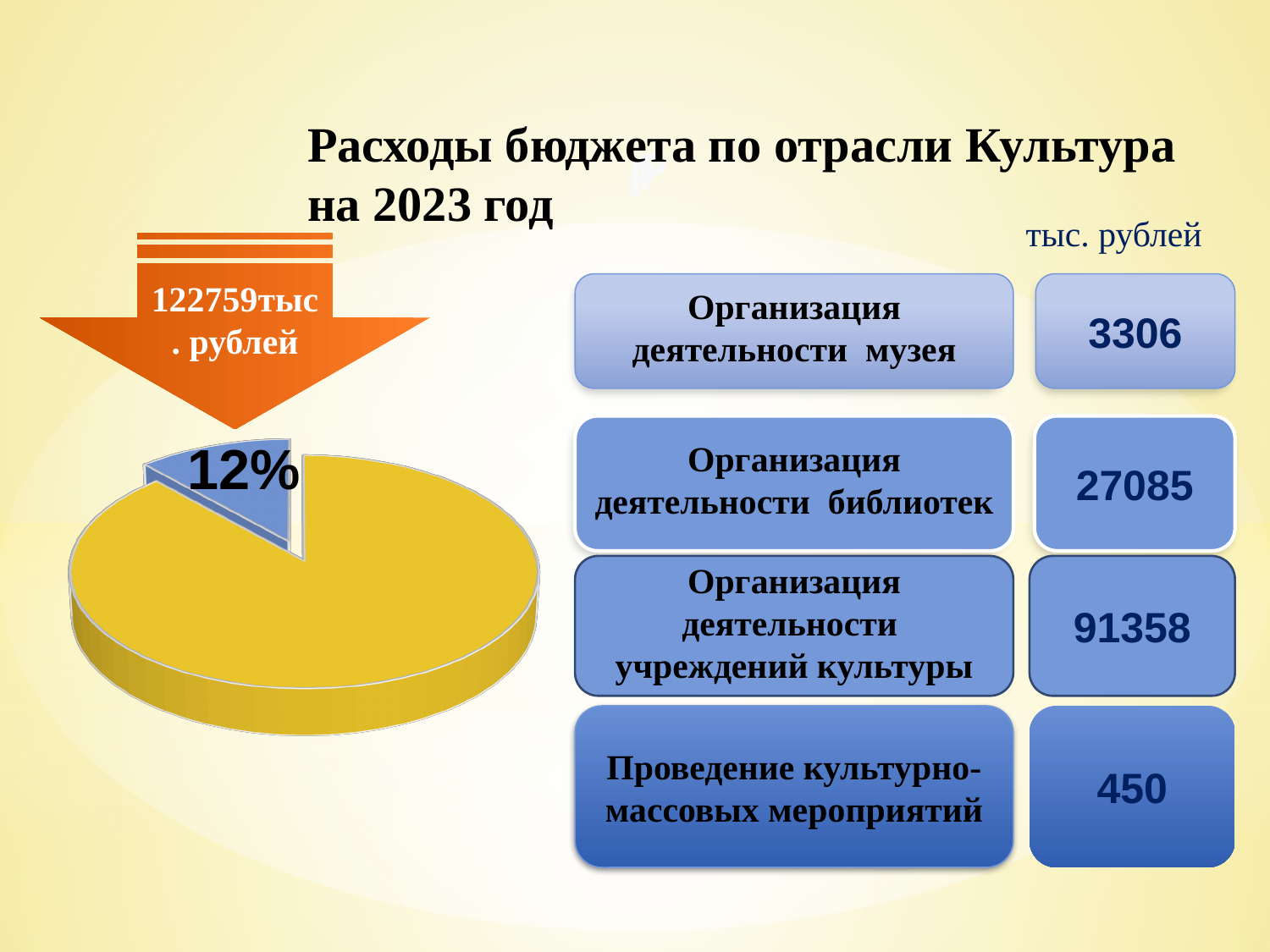
What colour is the slice labelled 12% in the pie chart? Blue How many slices does the pie chart have? 2 Is the share of the blue slice greater or less than 50%? less What share of the pie does the yellow slice represent? 88% What share of the pie does the blue slice represent? 12% Is the share of the yellow slice greater or less than 50%? greater What kind of chart is shown on the slide? Pie chart Which slice of the pie chart is larger, the blue one or the yellow one? The yellow one Does the pie chart have a legend? No What percentage is printed on the blue slice of the pie chart? 12%